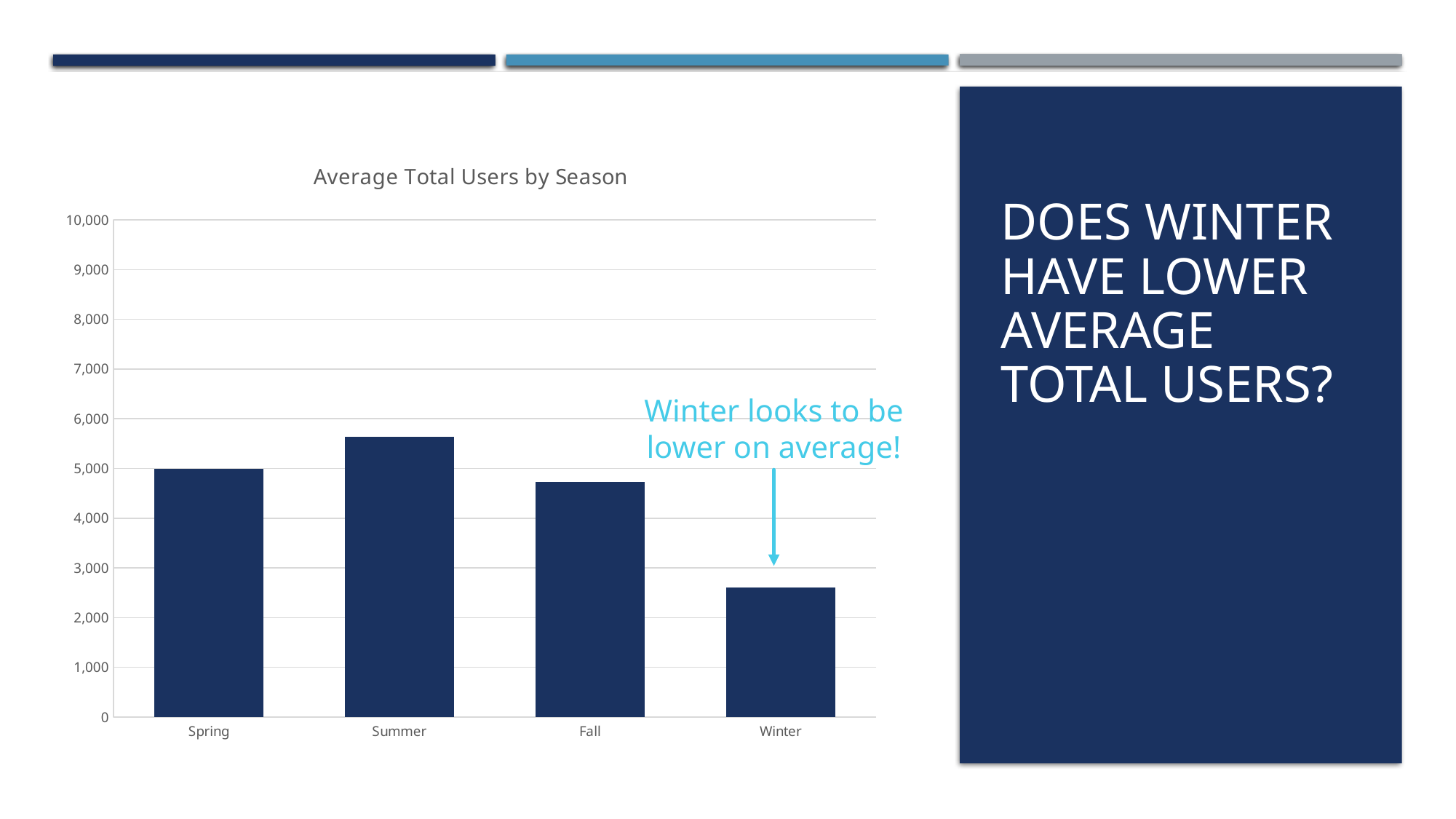
Which has a higher value, Summer or Fall? Summer What kind of chart is shown on the slide? Bar chart Which season has the lowest average total users? Winter Is the value for Summer greater or less than 5,000? greater How many seasons are plotted in the chart? 4 Is the value for Winter greater or less than 3,000? less Which season has the highest average total users? Summer What does the annotation text pointing to the Winter bar say? Winter looks to be lower on average! Is the value for Fall greater or less than 5,000? less What is the title of the chart? Average Total Users by Season Which has a higher value, Spring or Winter? Spring Do the values rise or fall from Summer to Winter along the x axis? fall